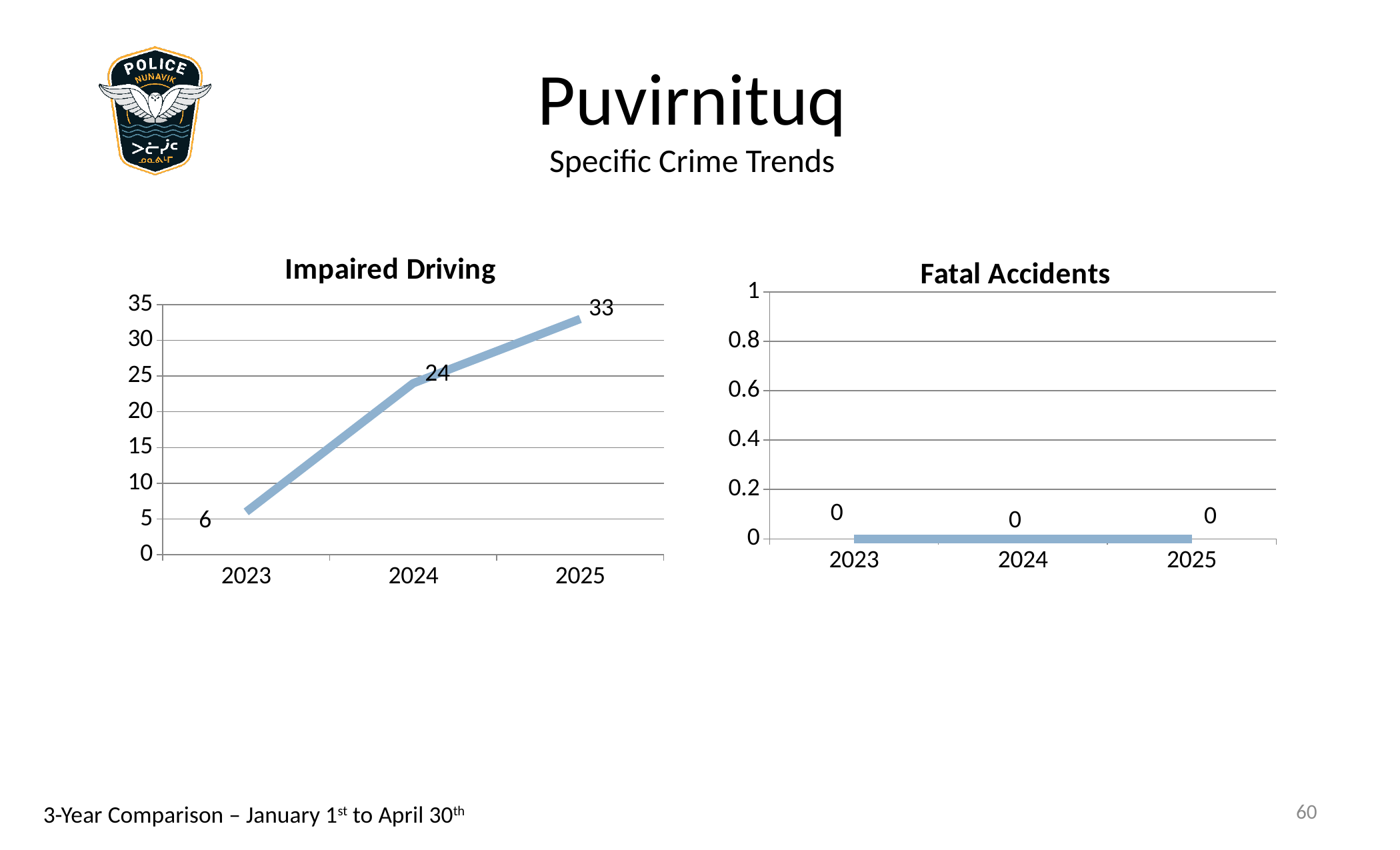
What is the title of the chart on the right side of the slide? Fatal Accidents In the Impaired Driving chart, what is the value for 2023? 6 In the Impaired Driving chart, do the values rise or fall from 2023 to 2025? rise In the Impaired Driving chart, how many years are plotted? 3 What kind of chart is the Impaired Driving chart? line chart In the Impaired Driving chart, what is the value for 2024? 24 In the Fatal Accidents chart, what is the value for 2024? 0 In the Impaired Driving chart, what is the difference between the 2025 and 2023 values? 27 In the Fatal Accidents chart, what is the total of the values for 2023, 2024 and 2025? 0 In the Impaired Driving chart, which is larger, the value for 2024 or the value for 2025? 2025 In the Impaired Driving chart, which year has the highest value? 2025 In the Impaired Driving chart, which year has the lowest value? 2023